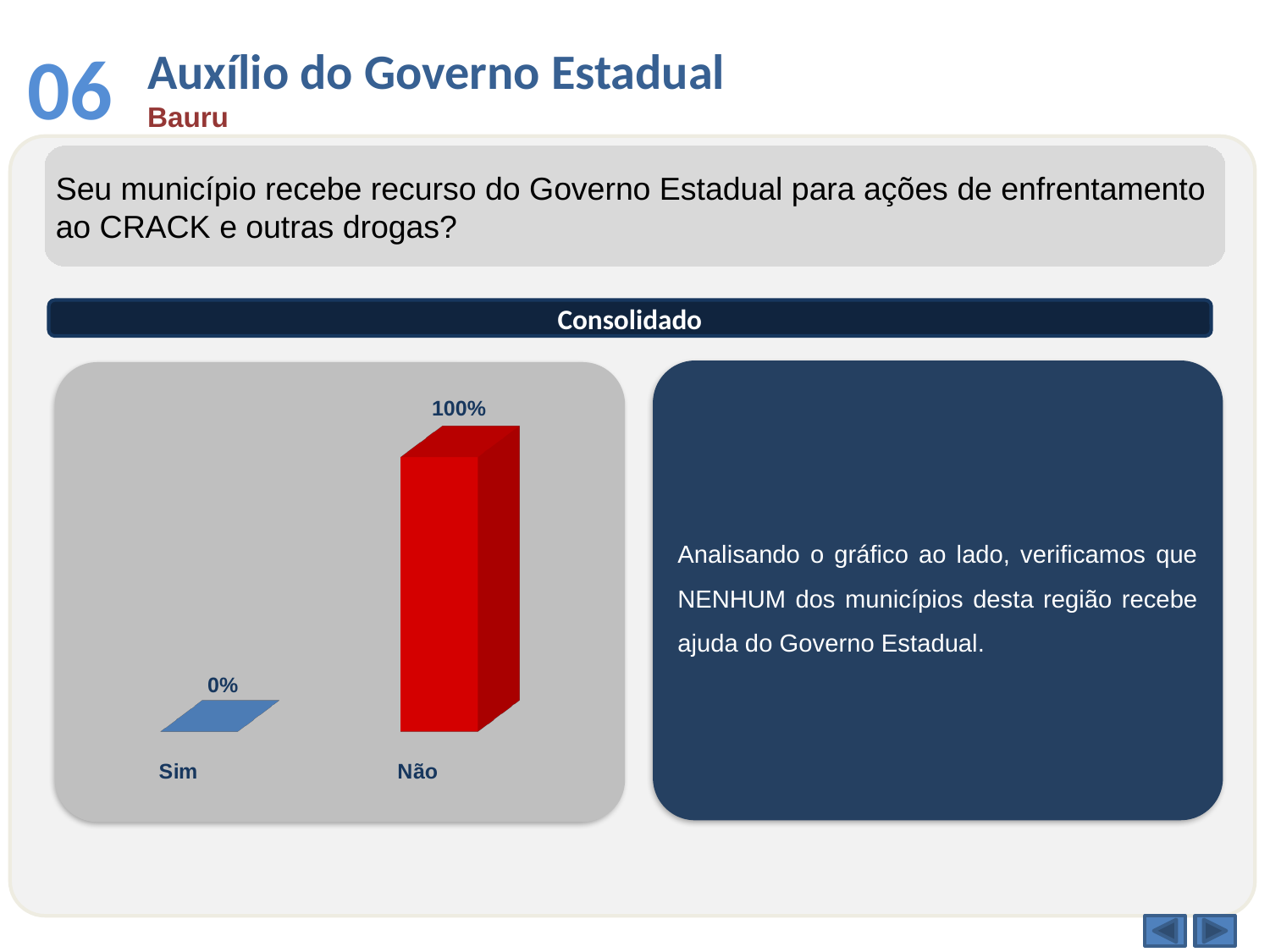
What colour is the bar for "Sim"? Blue What is the value for "Sim"? 0% What kind of chart is shown on the slide? Bar chart Which category has the lowest value? Sim What is the difference between the values for "Não" and "Sim"? 100% What colour is the bar for "Não"? Red Which is larger, the value for "Sim" or the value for "Não"? Não How many categories are shown in the chart? 2 What is the value for "Não"? 100% Which category has the highest value? Não